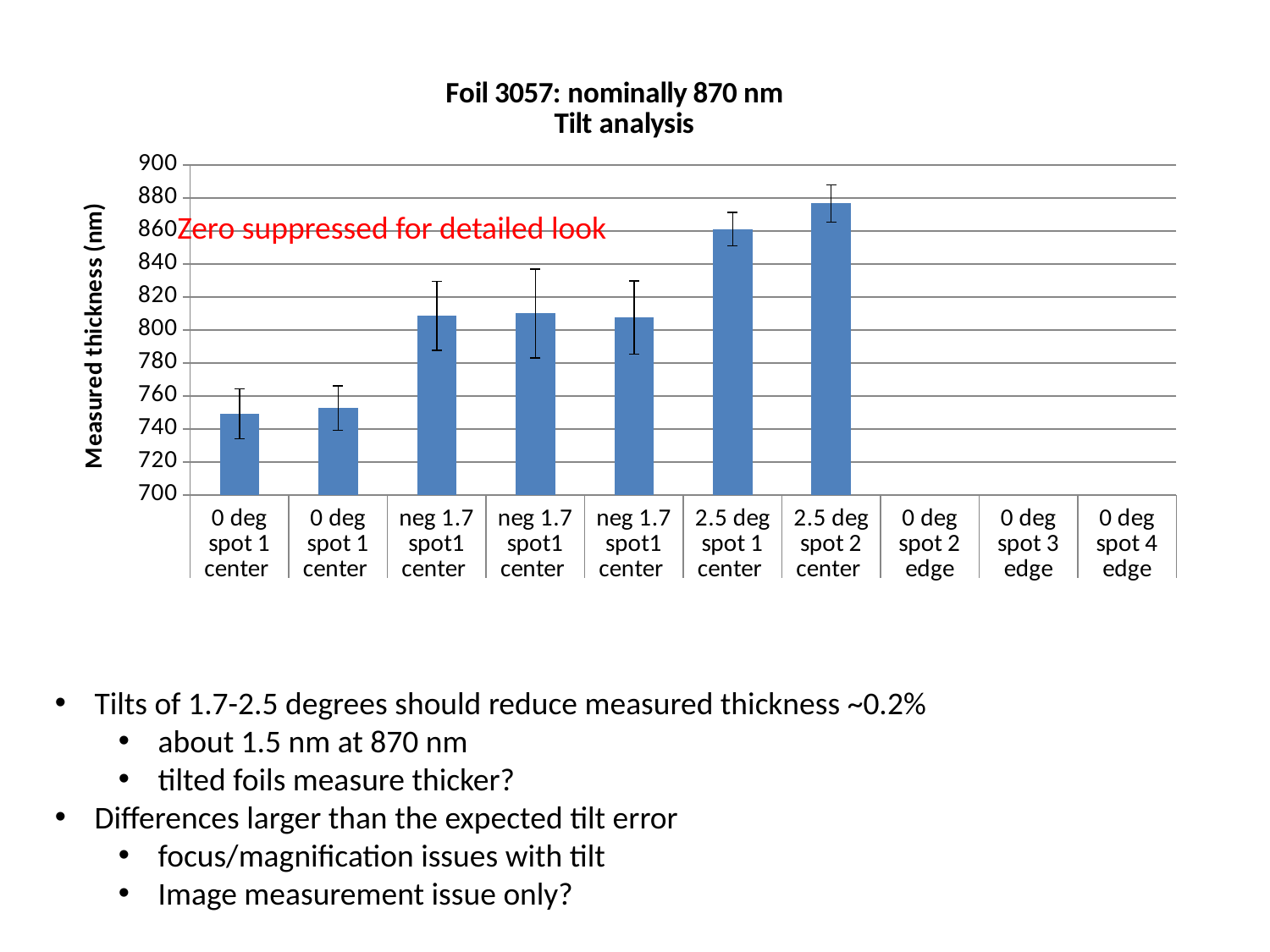
What is the title of the chart? Foil 3057: nominally 870 nm Tilt analysis What kind of chart is shown on the slide? bar chart How many categories have a visible bar plotted? 7 Is the value for 2.5 deg spot 1 center greater or less than 840? greater Which category has the highest measured thickness? 2.5 deg spot 2 center What is the label of the vertical axis? Measured thickness (nm) Do the plotted bar values generally rise or fall from left to right along the x axis? rise Is the value for the first 0 deg spot 1 center bar greater or less than 760? less Which is larger, the value for 2.5 deg spot 1 center or the value for the first neg 1.7 spot1 center bar? 2.5 deg spot 1 center How many categories are listed along the x axis? 10 Among the plotted bars, which category has the lowest measured thickness? 0 deg spot 1 center Is the value for 2.5 deg spot 2 center greater or less than 860? greater